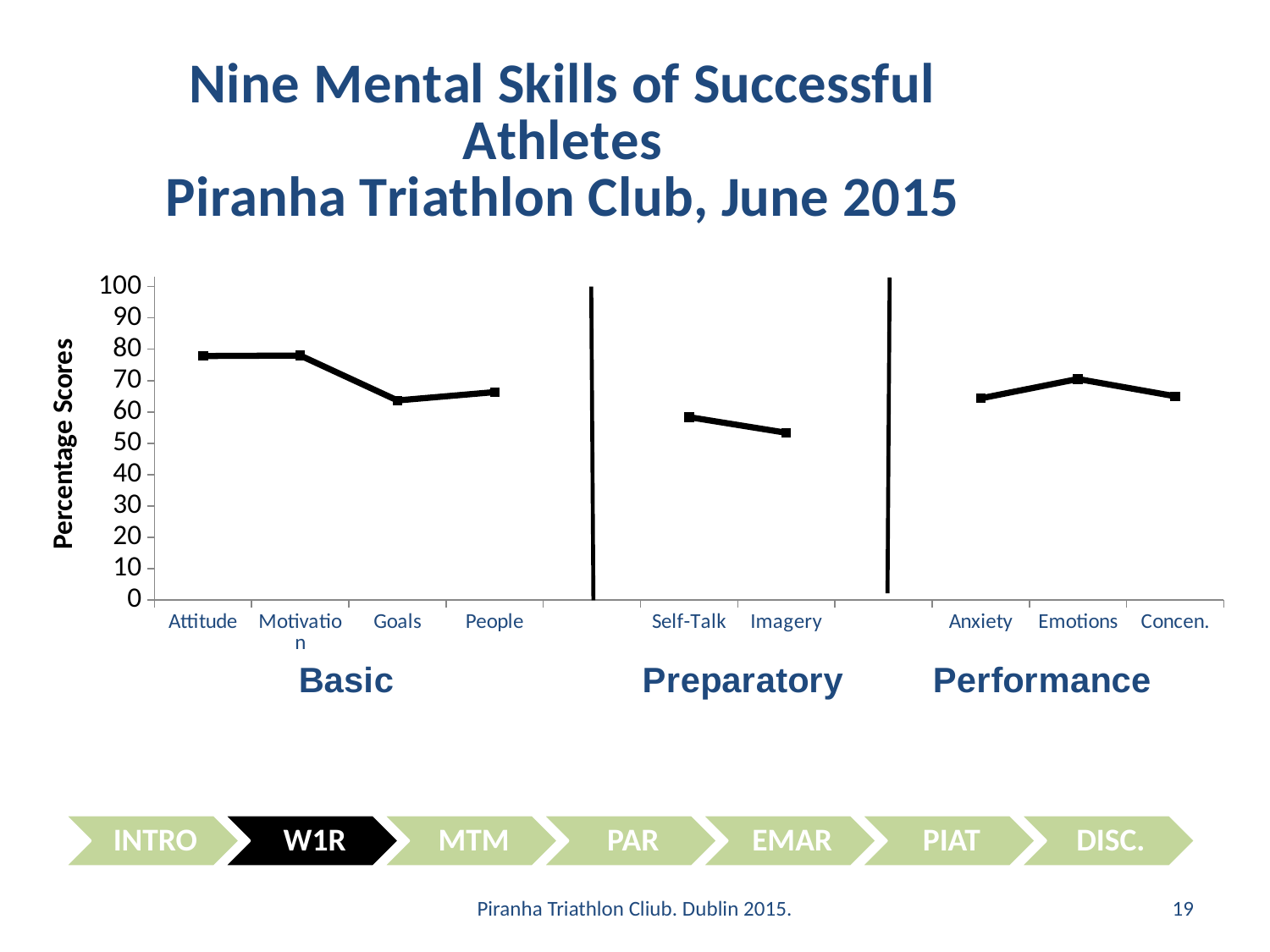
Which is larger, the value for Emotions or the value for Anxiety? Emotions How many mental skills (categories) are plotted along the x axis? 9 Which category has the lowest percentage score? Imagery What is the title of the vertical axis? Percentage Scores What kind of chart is shown on the slide? line chart Is the value for Emotions greater or less than 80? less Which is larger, the value for Attitude or the value for Goals? Attitude Is the value for Self-Talk greater or less than 60? less Do the values rise or fall from Self-Talk to Imagery? fall Is the value for Goals greater or less than 60? greater